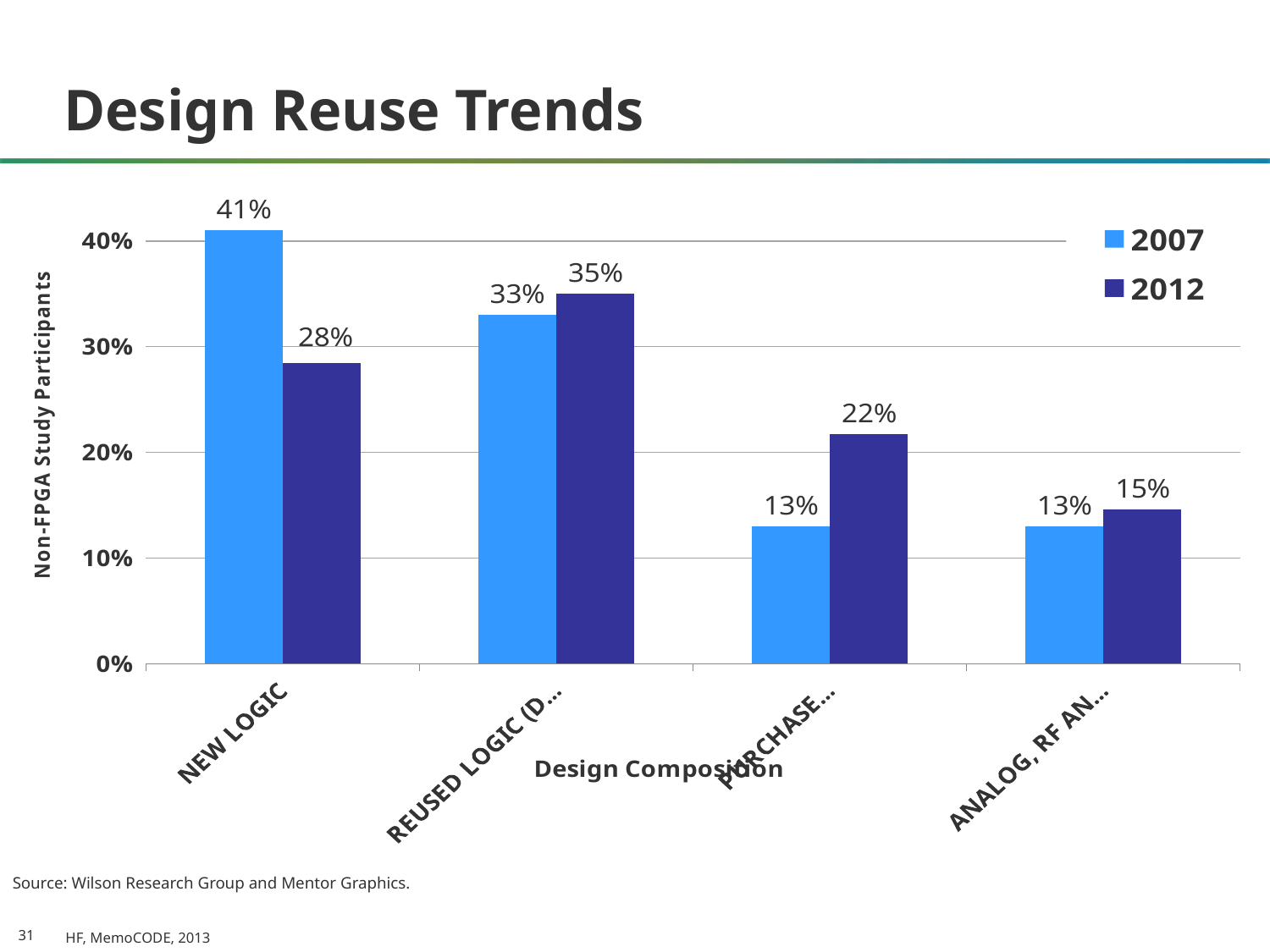
What is the 2012 value for the second category (REUSED LOGIC)? 35% What is the 2007 value for NEW LOGIC? 41% What is the 2007 value for the third category (PURCHASE...)? 13% How many series does the legend list? 2 What is the 2012 value for NEW LOGIC? 28% Which category has the highest 2007 value? NEW LOGIC For the second category (REUSED LOGIC), which year has the larger value, 2007 or 2012? 2012 What is the lowest value in the 2012 series? 15% What kind of chart is shown on the slide? Bar chart What is the title of the vertical axis? Non-FPGA Study Participants By how many percentage points did the NEW LOGIC value fall from 2007 to 2012? 13 percentage points How many categories are shown on the x axis? 4